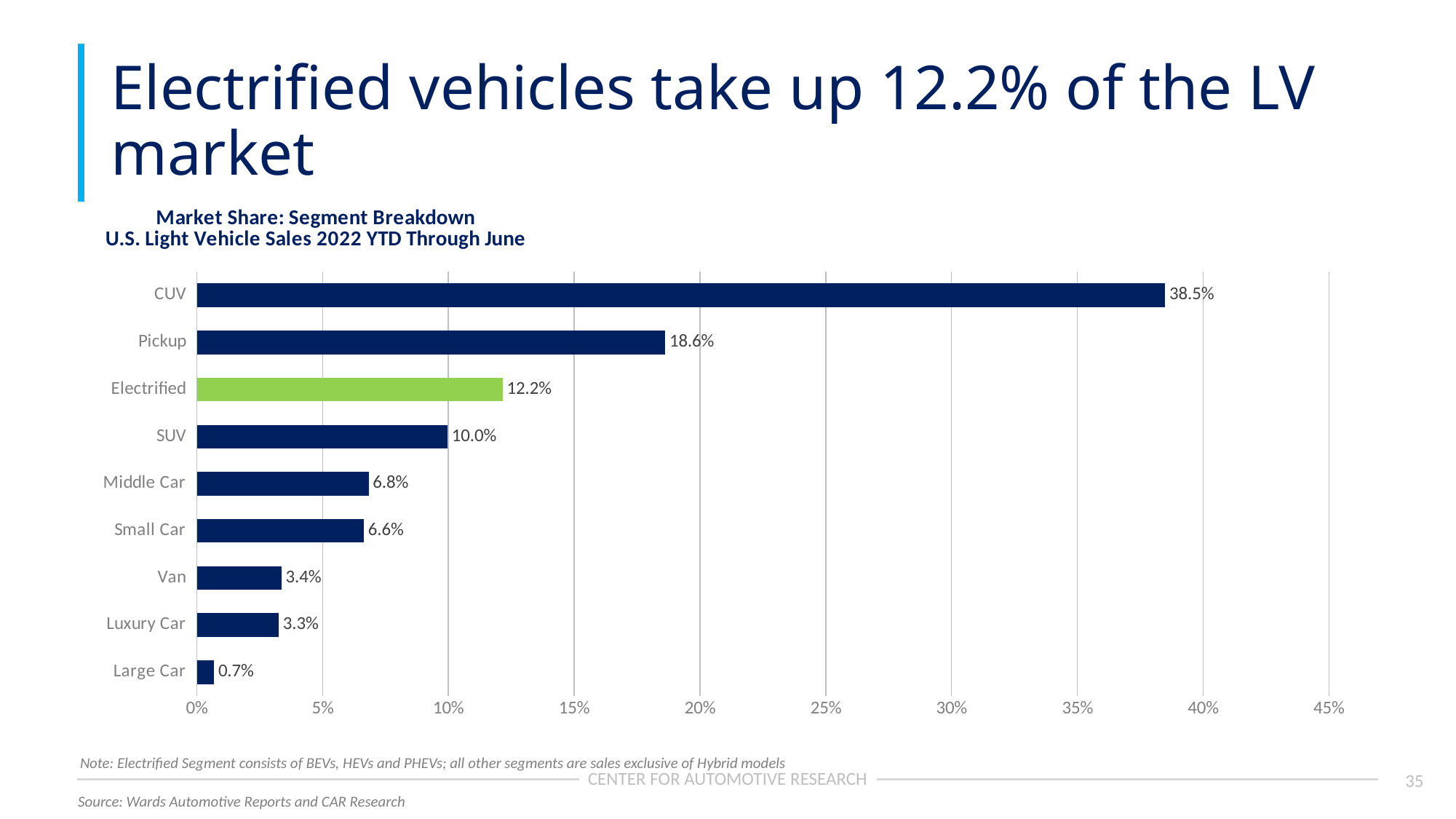
What is the difference in market share between Electrified and SUV? 2.2% Which has a larger market share, Pickup or SUV? Pickup Which segment has the lowest market share? Large Car Is the value for Pickup greater or less than 20%? less What is the market share for CUV? 38.5% What kind of chart is shown on the slide? Bar chart Which segment has the highest market share? CUV What is the difference in market share between CUV and Pickup? 19.9% Which bar is highlighted in green? Electrified What is the market share for Electrified vehicles? 12.2% How many segments are shown in the chart? 9 What is the market share for Van? 3.4%